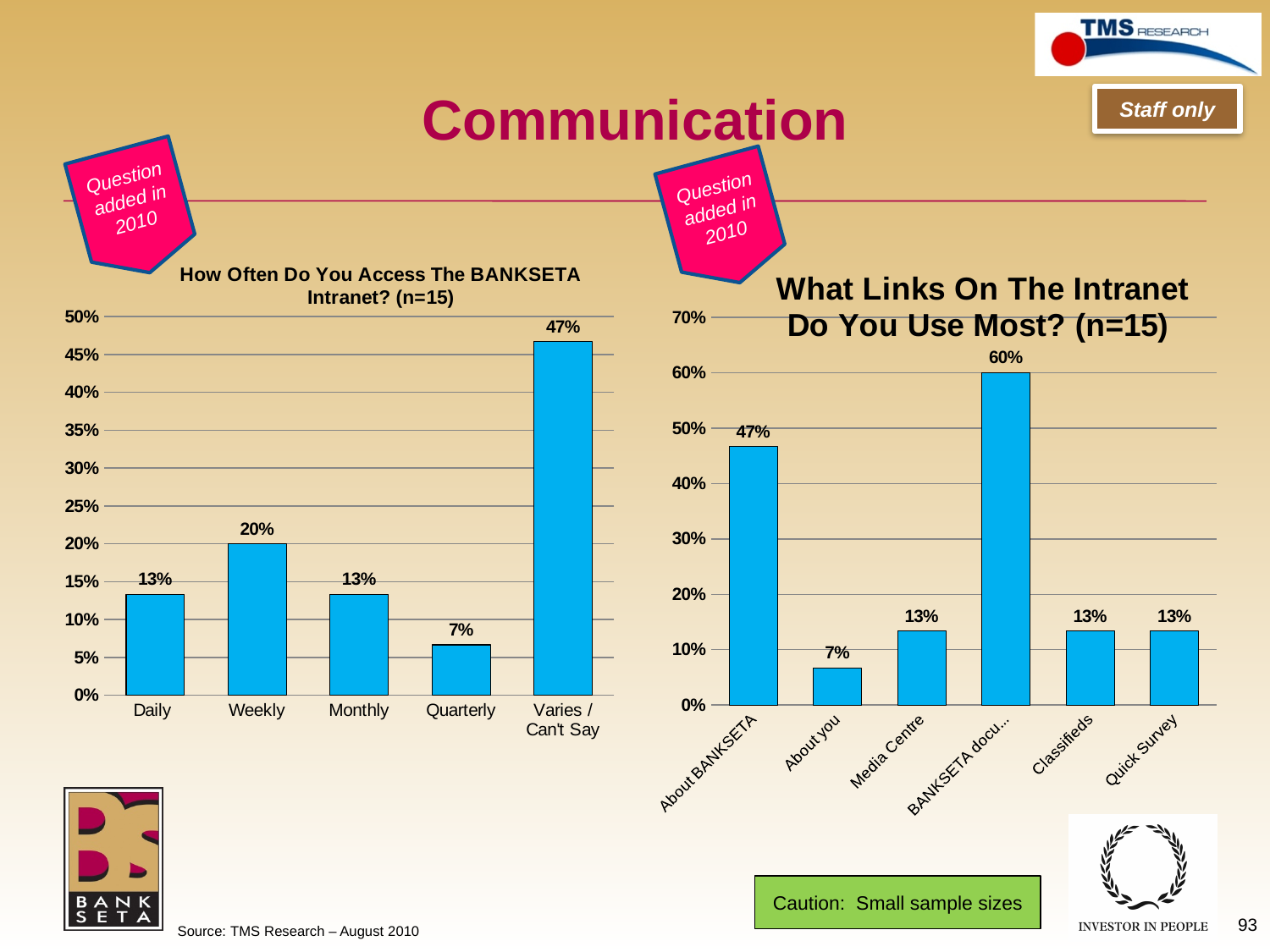
In the chart 'What Links On The Intranet Do You Use Most?', is the value for Media Centre larger or smaller than the value for About you? larger In the chart 'What Links On The Intranet Do You Use Most?', what is the difference between the values for BANKSETA docu... and About BANKSETA? 13% In the chart 'How Often Do You Access The BANKSETA Intranet?', which category has the lowest value? Quarterly In the chart 'How Often Do You Access The BANKSETA Intranet?', what is the value for Weekly? 20% In the chart 'What Links On The Intranet Do You Use Most?', how many categories are shown? 6 In the chart 'How Often Do You Access The BANKSETA Intranet?', how many categories are shown? 5 In the chart 'How Often Do You Access The BANKSETA Intranet?', what is the difference between the values for Varies / Can't Say and Weekly? 27% In the chart 'What Links On The Intranet Do You Use Most?', what is the value for About BANKSETA? 47% What type of chart is the chart on the right of the slide? Bar chart In the chart 'What Links On The Intranet Do You Use Most?', which category has the lowest value? About you In the chart 'How Often Do You Access The BANKSETA Intranet?', which category has the highest value? Varies / Can't Say In the chart 'What Links On The Intranet Do You Use Most?', which category has the highest value? BANKSETA docu...